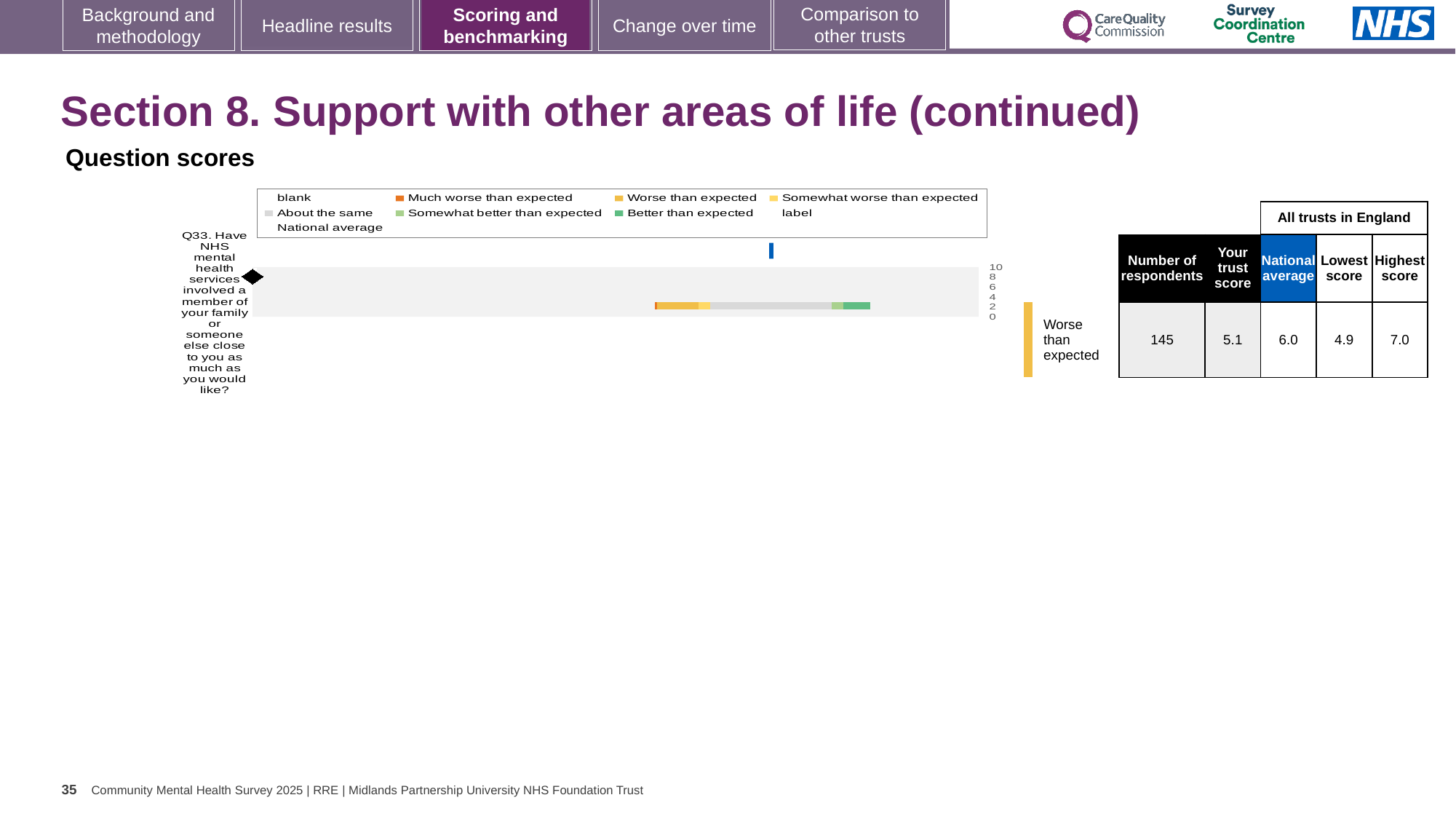
According to the table, what is the national average score for Q33? 6.0 How many entries does the chart legend list? 9 According to the table, what is the highest score among all trusts in England for Q33? 7.0 Which question is plotted on the chart? Q33. Have NHS mental health services involved a member of your family or someone else close to you as much as you would like? What rating label is shown to the right of the chart for Q33? Worse than expected According to the table, what is the trust's score for Q33? 5.1 According to the table, how many respondents answered Q33? 145 What is the highest value shown on the chart's axis? 10 What kind of chart is shown on the slide? bar chart How many questions (categories) are plotted on the chart? 1 According to the table, what is the lowest score among all trusts in England for Q33? 4.9 Which is larger for Q33, the trust's score or the national average? national average